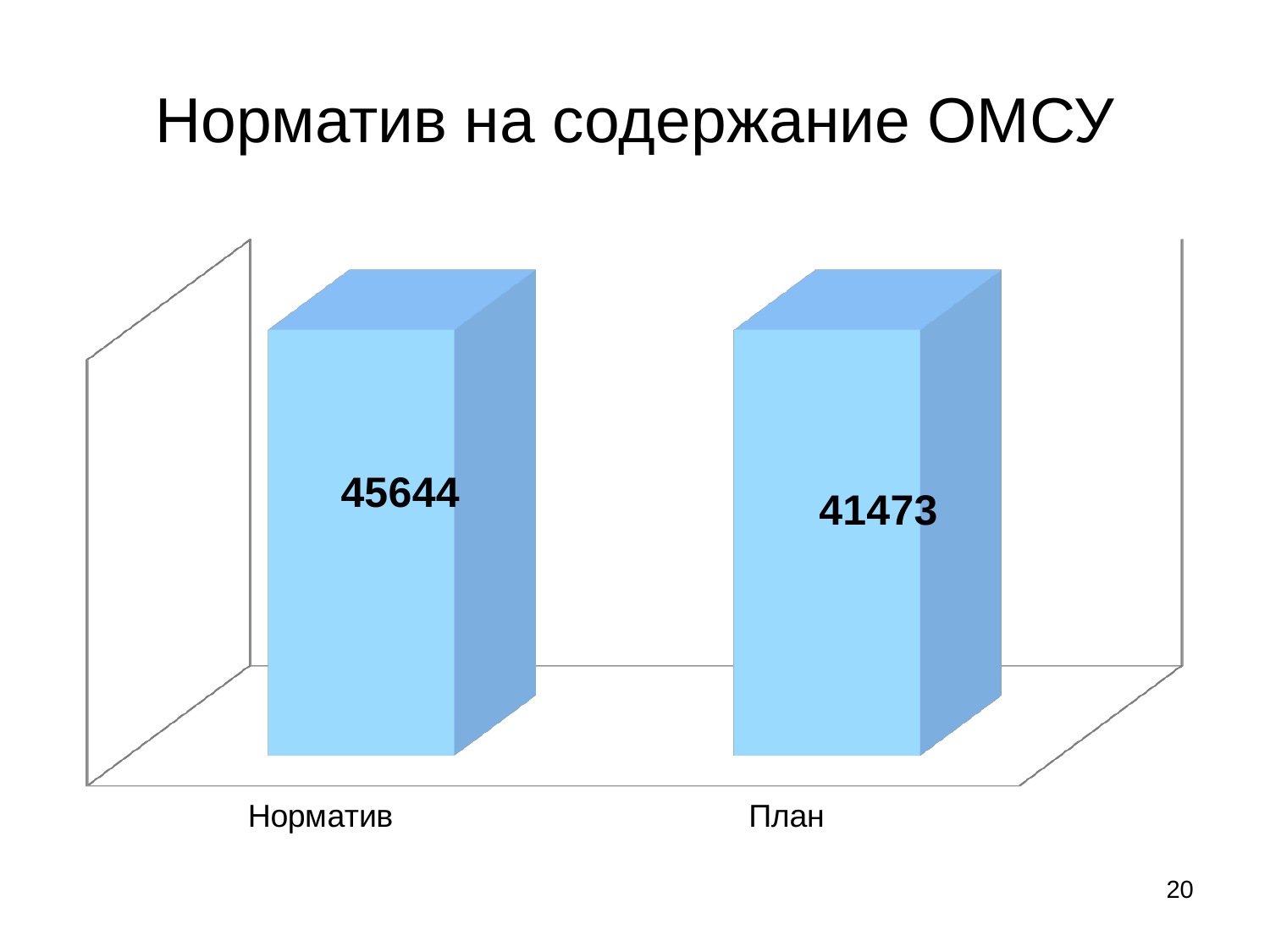
How many categories are shown in the chart? 2 What colour are the bars in the chart? light blue What is the value for План? 41473 What kind of chart is shown on the slide? bar chart Which is larger, the value for Норматив or the value for План? Норматив Which category has the highest value? Норматив Which category has the lowest value? План What is the value for Норматив? 45644 What is the difference between the values for Норматив and План? 4171 What is the title of the chart? Норматив на содержание ОМСУ